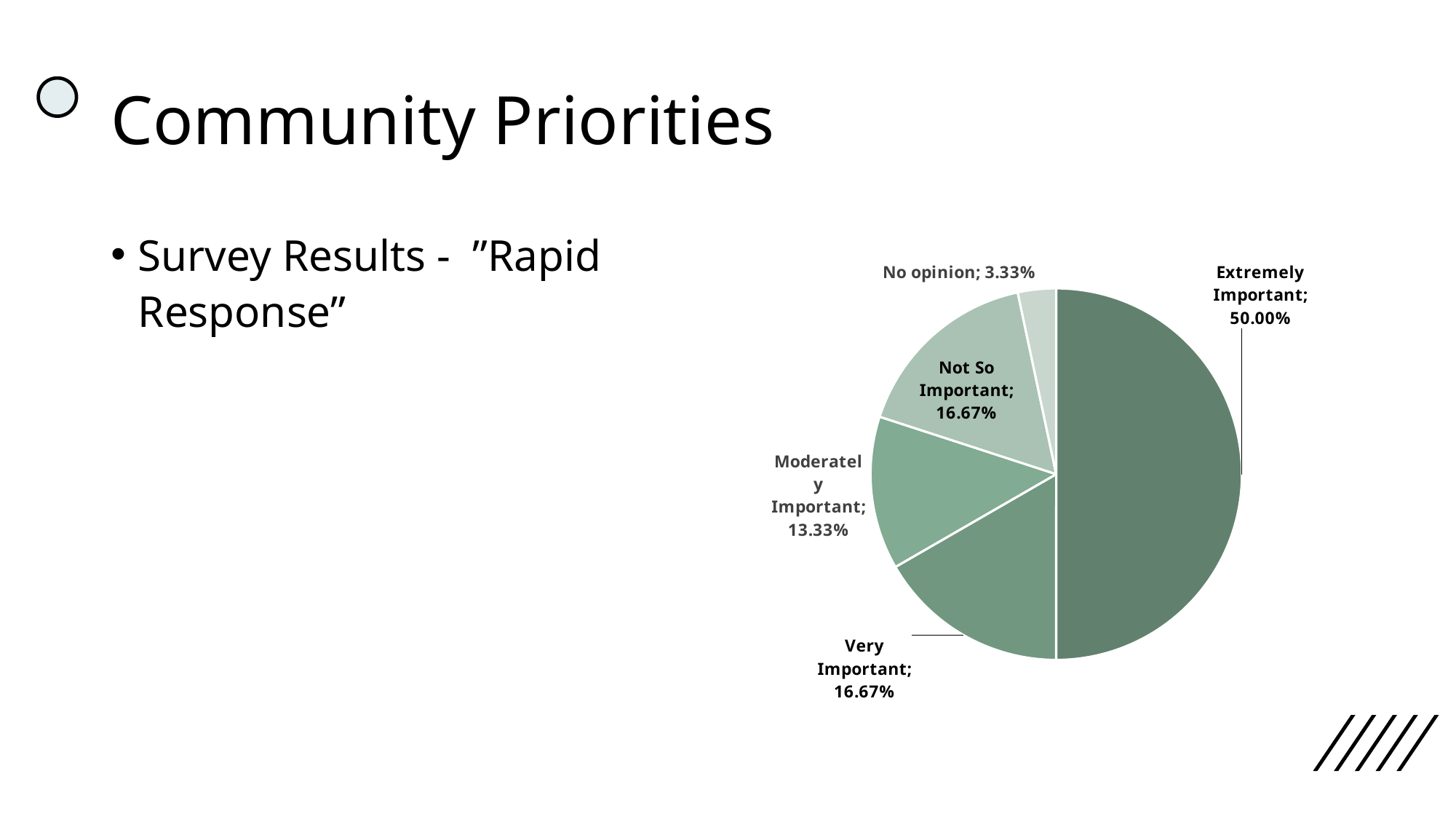
What is the value for "Moderately Important"? 13.33% Which category has the largest slice of the pie? Extremely Important What kind of chart is shown on the slide? pie chart What is the value for "Very Important"? 16.67% How many slices does the pie chart have? 5 What is the difference between the "Extremely Important" and "Very Important" values? 33.33% What share of the pie does the "Extremely Important" slice represent? 50.00% Which is larger, the value for "Not So Important" or the value for "Moderately Important"? Not So Important Which survey question do the pie chart results relate to, according to the bullet text? Rapid Response What is the difference between the "Moderately Important" and "No opinion" values? 10.00% What is the value for "No opinion"? 3.33% Which category has the smallest slice of the pie? No opinion